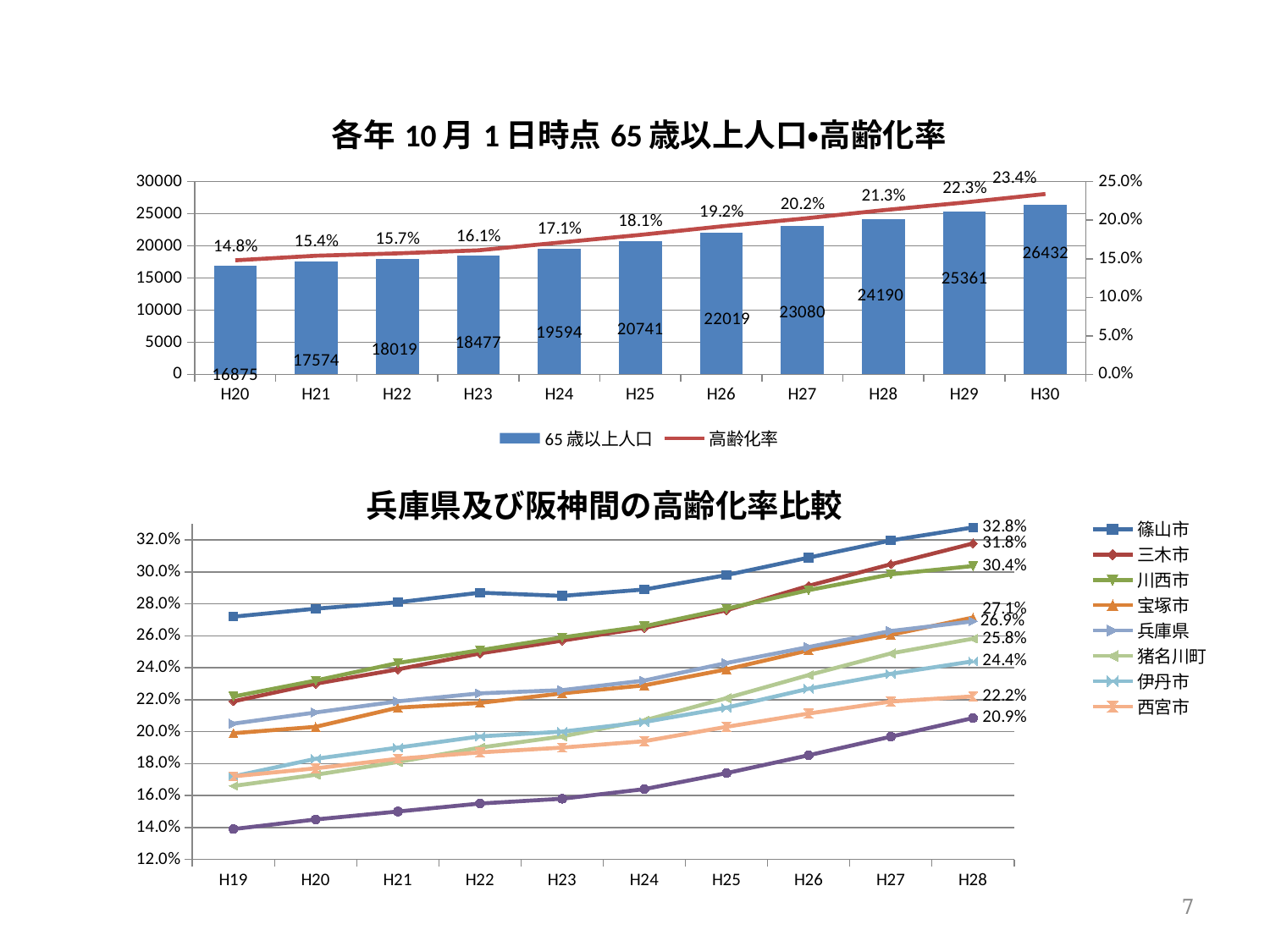
In the top chart (各年 10月 1日時点 65歳以上人口•高齢化率), what is the 65歳以上人口 value for H30? 26432 In the top chart, what is the 高齢化率 for H25? 18.1% In the bottom chart, how many series does the legend list? 8 In the top chart, how many series does the legend list? 2 In the top chart, how many years are shown on the x axis? 11 What kind of chart is the bottom chart? line chart In the top chart, which year has the lowest 65歳以上人口? H20 In the top chart, what is the difference in 65歳以上人口 between H30 and H20? 9557 In the top chart, is the 65歳以上人口 for H28 greater or less than 20000? greater In the bottom chart (兵庫県及び阪神間の高齢化率比較), what is the value for 篠山市 at H28? 32.8% In the top chart, does the 高齢化率 rise or fall from H20 to H30? rise In the bottom chart, which series has the highest value at H28? 篠山市